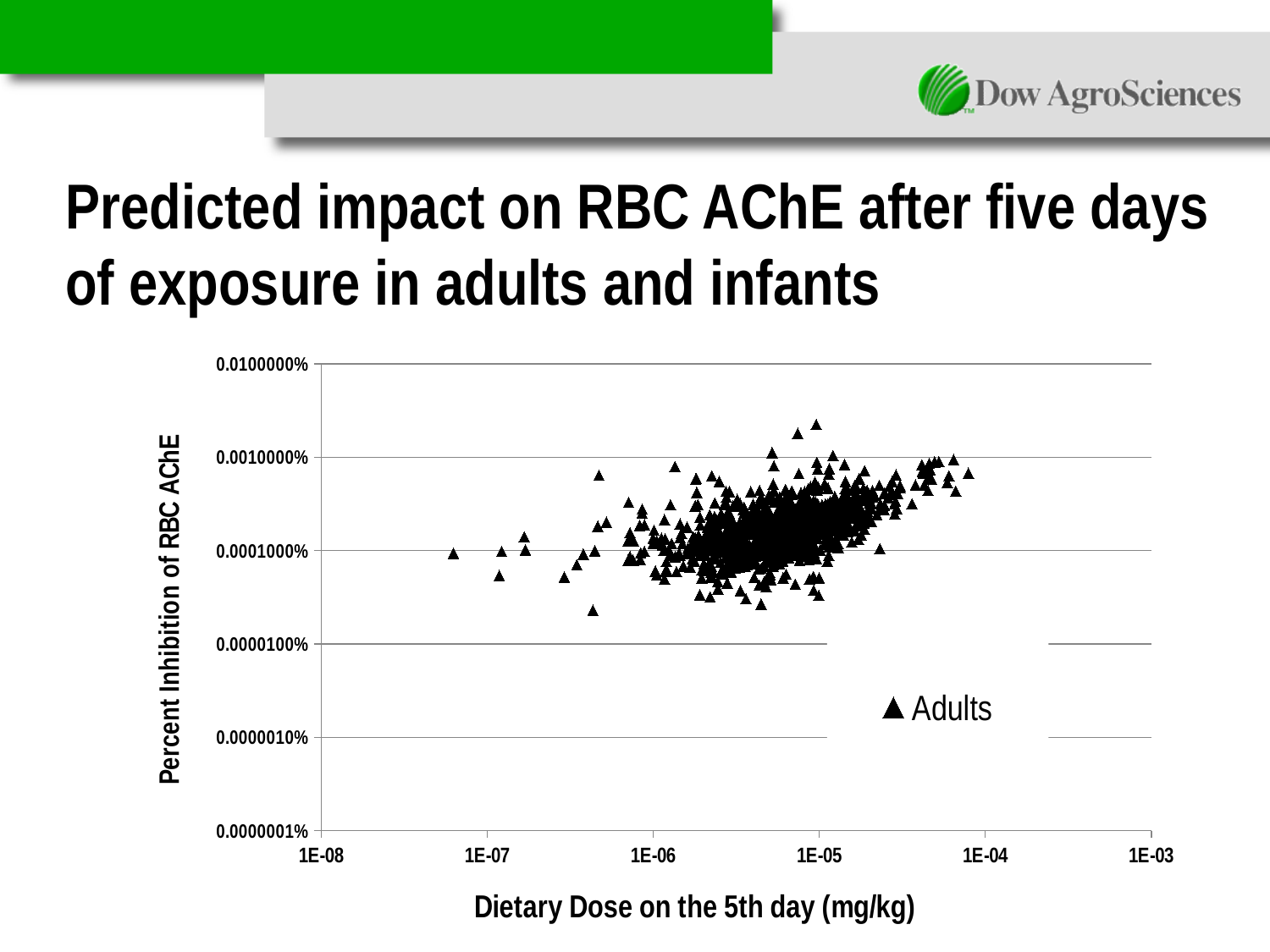
What kind of chart is shown on the slide? scatter plot Is the dietary dose of the rightmost plotted point greater or less than 1E-04 mg/kg? less How many series does the chart legend list? 1 Is the dietary dose of the leftmost plotted point greater or less than 1E-07 mg/kg? less What is the name of the series shown in the chart legend? Adults Is the highest plotted point for Adults greater or less than 0.0010000% on the y axis? greater What is the title of the x axis of the chart? Dietary Dose on the 5th day (mg/kg) Do the plotted values generally rise or fall as the dietary dose increases along the x axis? rise